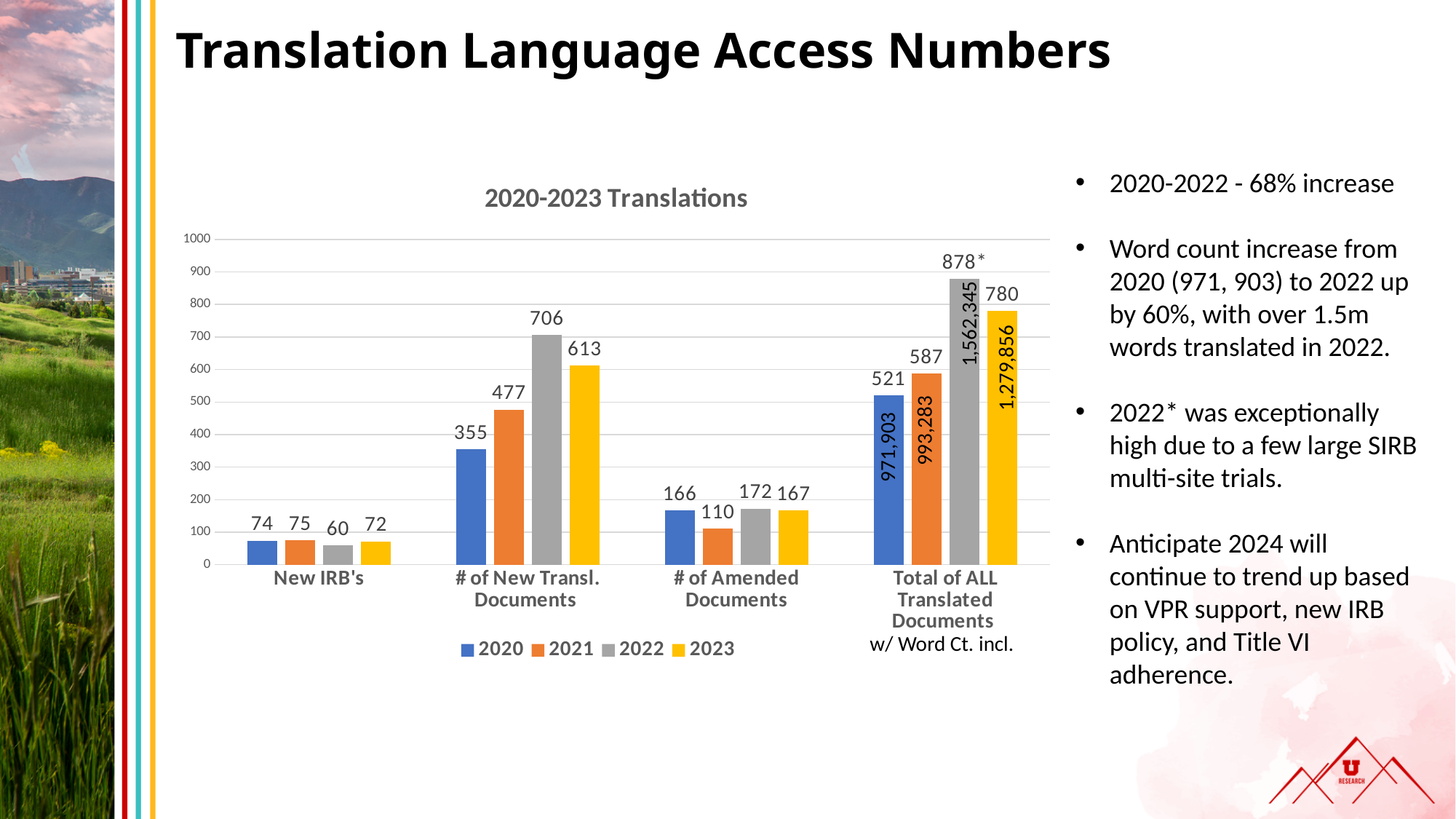
What is the difference between the 2022 and 2020 values in the # of New Transl. Documents category? 351 What is the value for 2023 in the Total of ALL Translated Documents category? 780 What type of chart is shown on the slide? bar chart What is the title of the chart? 2020-2023 Translations Which year has the lowest value in the New IRB's category? 2022 Which is larger in the # of Amended Documents category, the 2020 value or the 2023 value? 2023 How many series does the legend list? 4 What word count is labelled on the 2022 bar in the Total of ALL Translated Documents category? 1,562,345 Which year has the highest value in the Total of ALL Translated Documents category? 2022 How many categories are shown on the x axis? 4 What is the value for 2022 in the # of New Transl. Documents category? 706 What is the value for 2021 in the # of Amended Documents category? 110